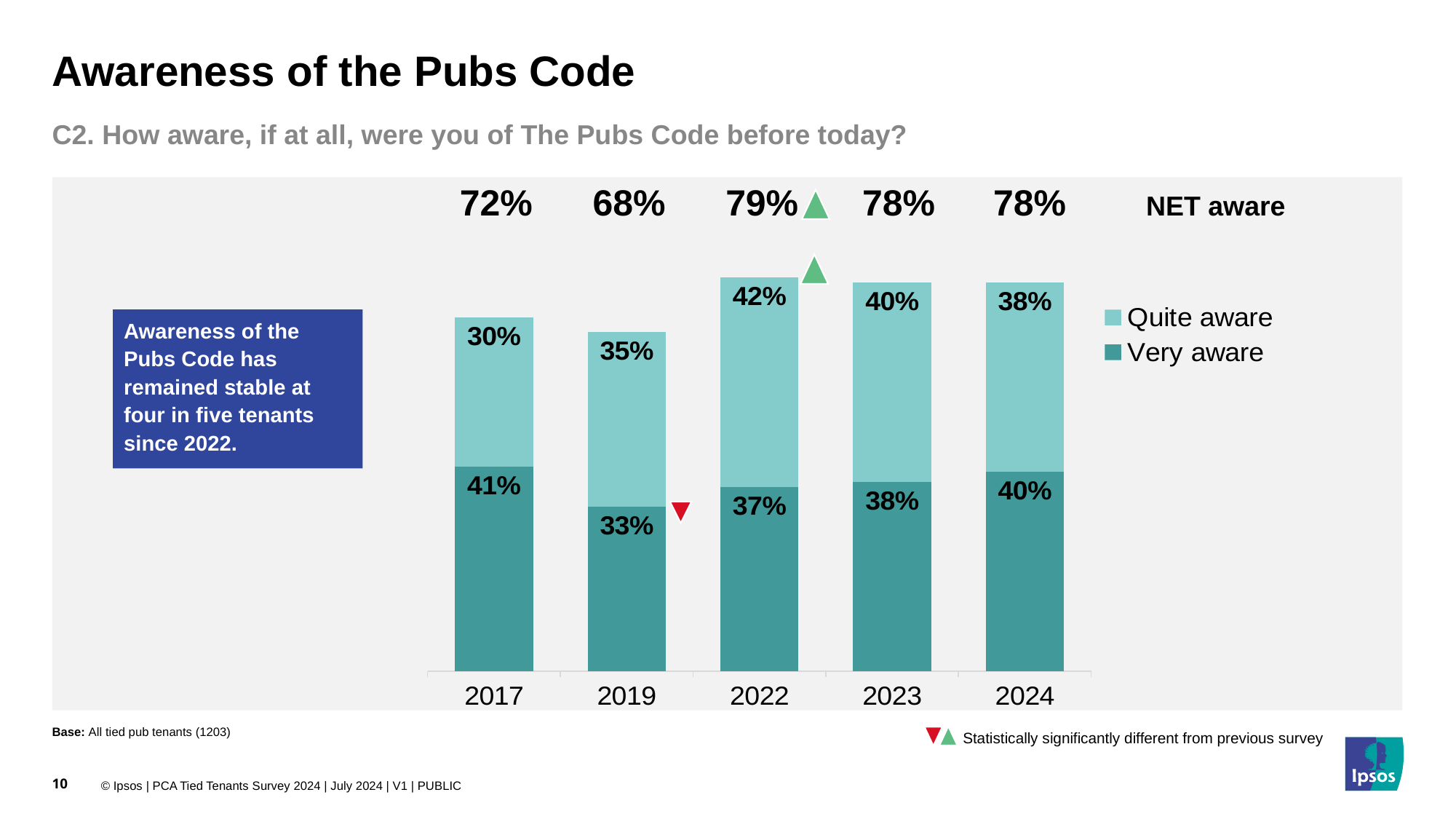
Which year is marked with a green triangle indicating a statistically significant increase in NET aware from the previous survey? 2022 By how many percentage points did the 'Very aware' figure in 2024 exceed that in 2019? 7 percentage points What is the NET aware figure shown for 2019? 68% What percentage of tenants were 'Very aware' of the Pubs Code in 2017? 41% Which year has the lowest 'Very aware' percentage? 2019 Which year has the highest 'Very aware' percentage? 2017 How many series does the legend list? 2 Which year has the larger 'Quite aware' percentage, 2023 or 2024? 2023 What kind of chart is used on this slide? Stacked bar chart What percentage of tenants were 'Quite aware' of the Pubs Code in 2022? 42% Which year has the highest 'Quite aware' percentage? 2022 How many survey years are shown on the x axis? 5